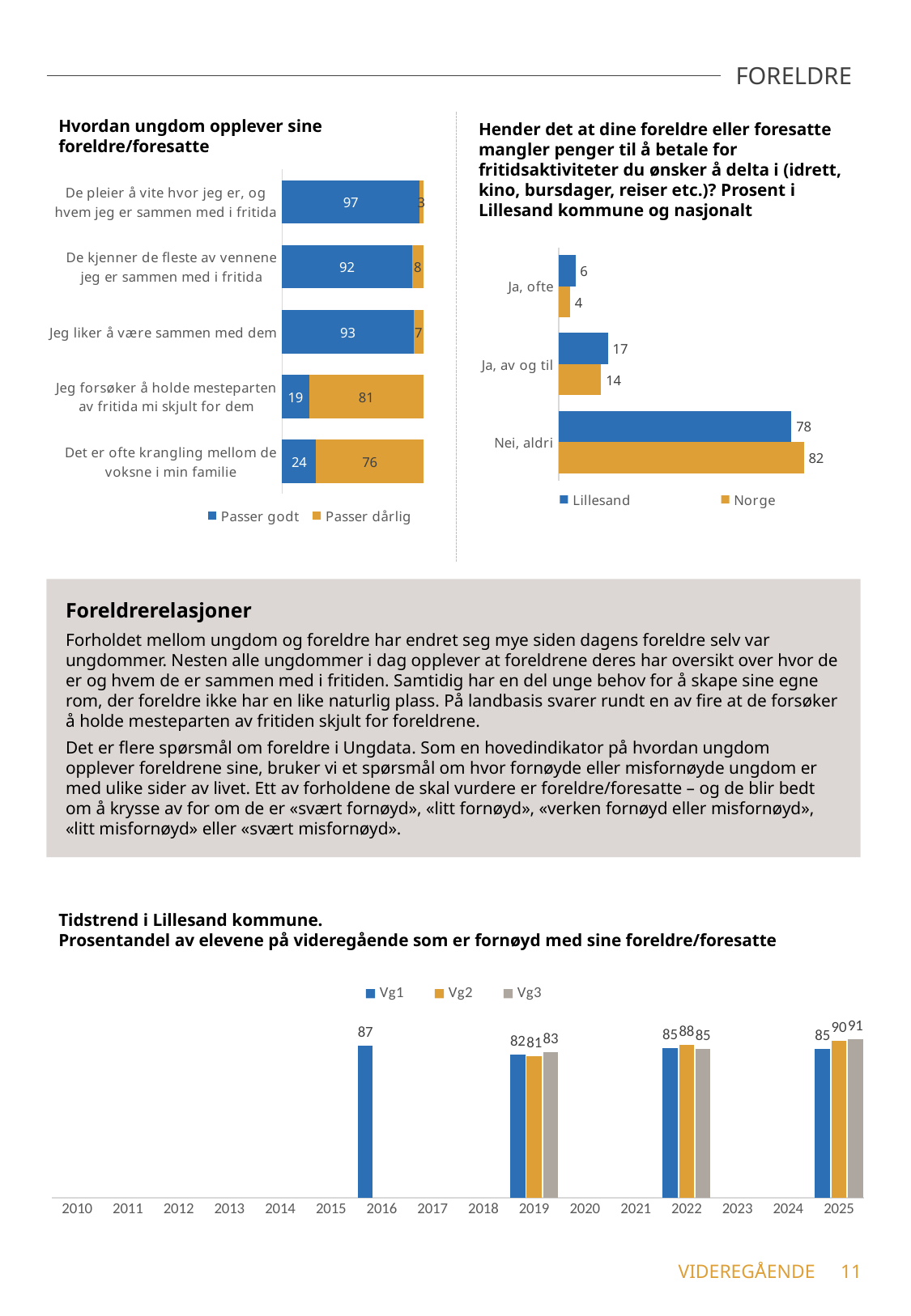
In the chart 'Hvordan ungdom opplever sine foreldre/foresatte', what is the 'Passer godt' value for 'De pleier å vite hvor jeg er, og hvem jeg er sammen med i fritida'? 97 In the chart 'Tidstrend i Lillesand kommune', what is the Vg2 value for 2025? 90 In the chart 'Hvordan ungdom opplever sine foreldre/foresatte', how many series does the legend list? 2 In the chart 'Tidstrend i Lillesand kommune', what is the difference between the Vg2 values for 2022 and 2019? 7 In the chart 'Hvordan ungdom opplever sine foreldre/foresatte', which category has the lowest 'Passer godt' value? Jeg forsøker å holde mesteparten av fritida mi skjult for dem In the chart 'Hender det at dine foreldre eller foresatte mangler penger...', which is larger for 'Ja, ofte': Lillesand or Norge? Lillesand In the chart 'Tidstrend i Lillesand kommune', what is the Vg1 value for 2016? 87 In the chart 'Hender det at dine foreldre eller foresatte mangler penger...', what is the Lillesand value for 'Nei, aldri'? 78 In the chart 'Hvordan ungdom opplever sine foreldre/foresatte', what is the 'Passer dårlig' value for 'Jeg forsøker å holde mesteparten av fritida mi skjult for dem'? 81 In the chart 'Hender det at dine foreldre eller foresatte mangler penger...', what is the difference between the Norge and Lillesand values for 'Nei, aldri'? 4 In the chart 'Hender det at dine foreldre eller foresatte mangler penger...', how many categories are shown? 3 In the chart 'Hender det at dine foreldre eller foresatte mangler penger...', what is the Norge value for 'Ja, av og til'? 14